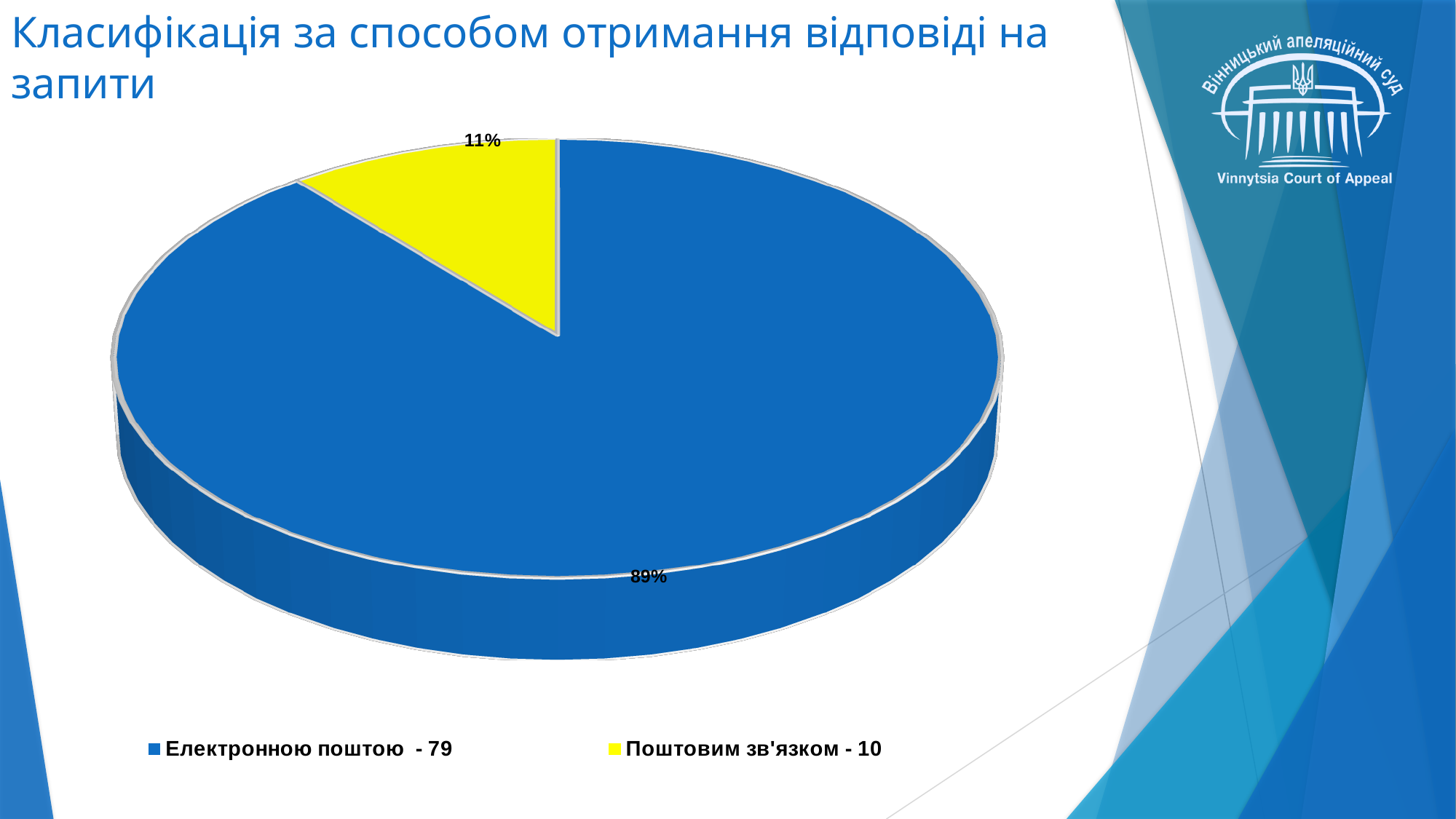
What percentage share does the slice for "Поштовим зв'язком" have? 11% What is the difference in percentage points between the "Електронною поштою" slice and the "Поштовим зв'язком" slice? 78 What percentage share does the slice for "Електронною поштою" have? 89% How many slices does the pie chart have? 2 What is the title of the slide containing the pie chart? Класифікація за способом отримання відповіді на запити What kind of chart is shown on the slide? Pie chart Which category has the largest slice of the pie? Електронною поштою Which category has the smallest slice of the pie? Поштовим зв'язком According to the legend, how many responses were received by e-mail ("Електронною поштою")? 79 Which slice is larger: "Електронною поштою" or "Поштовим зв'язком"? Електронною поштою According to the legend, how many responses were received by post ("Поштовим зв'язком")? 10 What colour is the slice for "Поштовим зв'язком"? Yellow